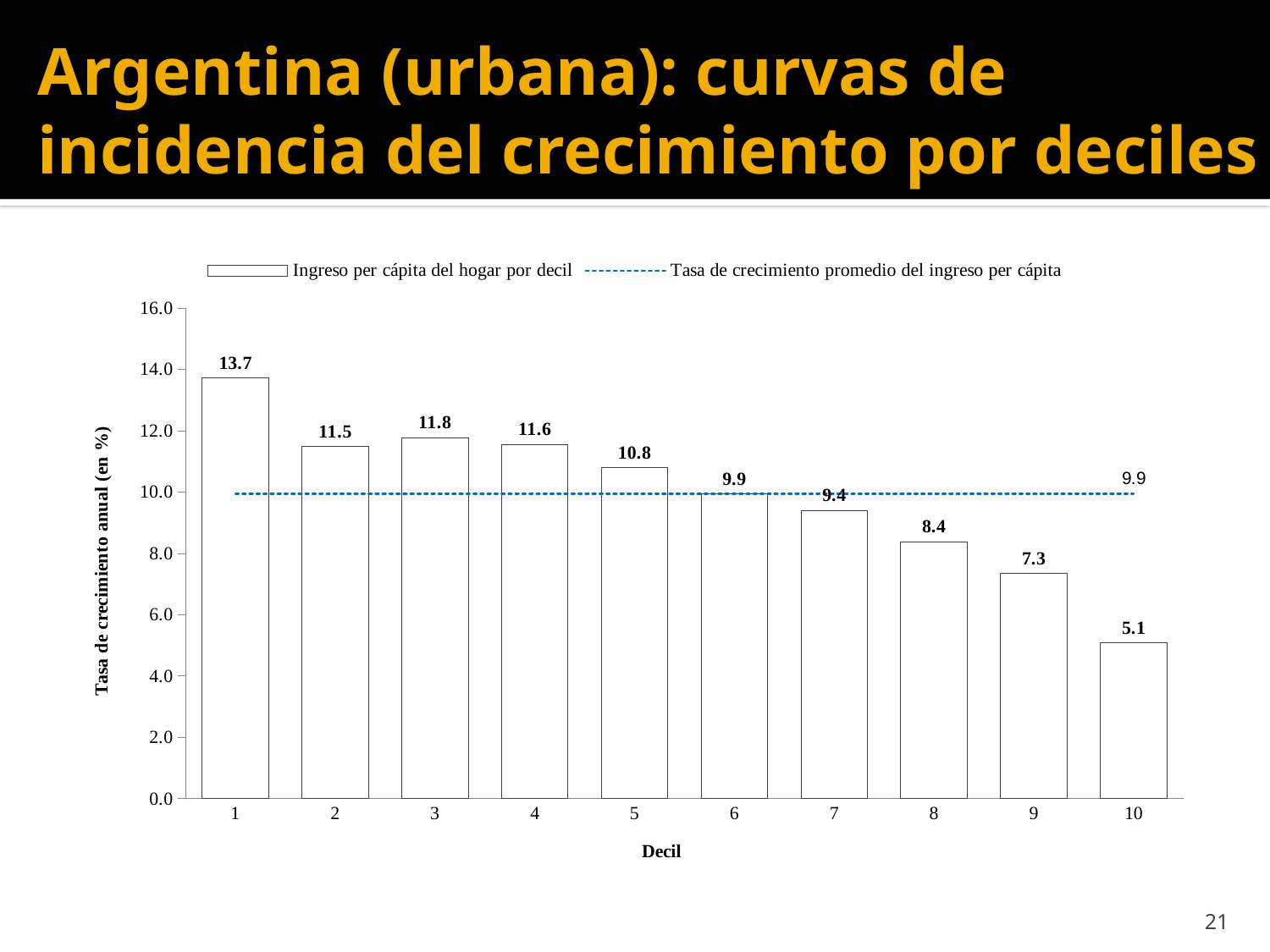
How many series does the legend list? 2 How many deciles are shown on the x axis? 10 What kind of chart is shown on the slide? Combination bar and line chart What value does the dashed line for the average growth rate of per capita income show? 9.9 What is the annual growth rate for decile 10? 5.1 Do the growth rates generally rise or fall from decile 1 to decile 10? Fall What is the annual growth rate for decile 5? 10.8 Which decile has the highest annual growth rate? 1 What is the difference between the growth rate of decile 1 and decile 10? 8.6 Which decile has the lowest annual growth rate? 10 Which has a higher growth rate, decile 3 or decile 8? Decile 3 What is the annual growth rate for decile 1? 13.7